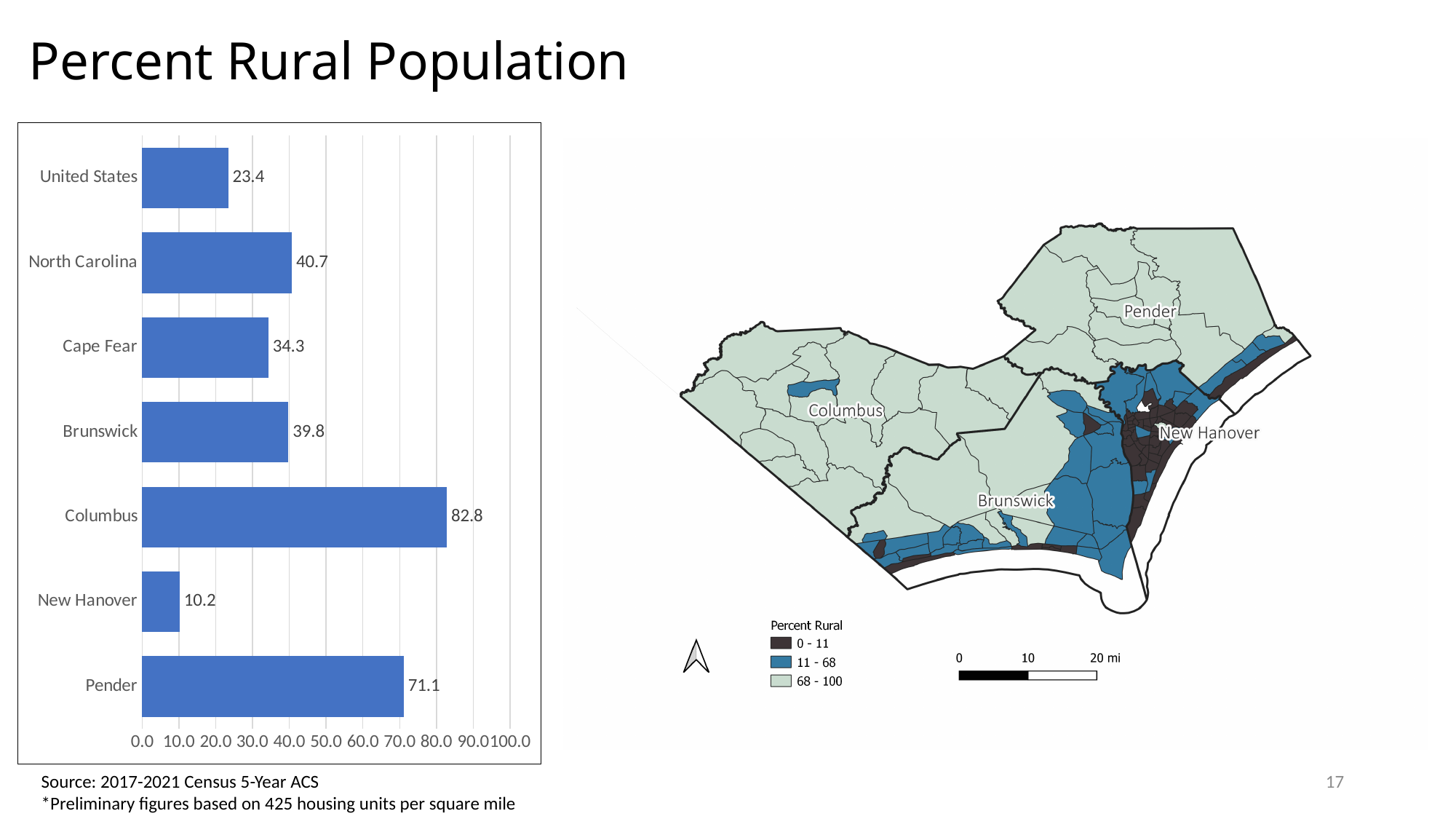
What is the value shown for New Hanover in the bar chart? 10.2 How many categories are shown in the bar chart? 7 Which category has the lowest value in the bar chart? New Hanover What is the difference between the values for North Carolina and the United States in the bar chart? 17.3 Which has a larger value in the bar chart, Brunswick or Cape Fear? Brunswick What is the value shown for North Carolina in the bar chart? 40.7 How many ranges does the map legend titled 'Percent Rural' list? 3 Which category has the highest value in the bar chart? Columbus What kind of chart is shown on the left of the slide? Bar chart What is the difference between the values for Columbus and Pender in the bar chart? 11.7 What is the percent rural population value for Columbus in the bar chart? 82.8 What is the value shown for Pender in the bar chart? 71.1